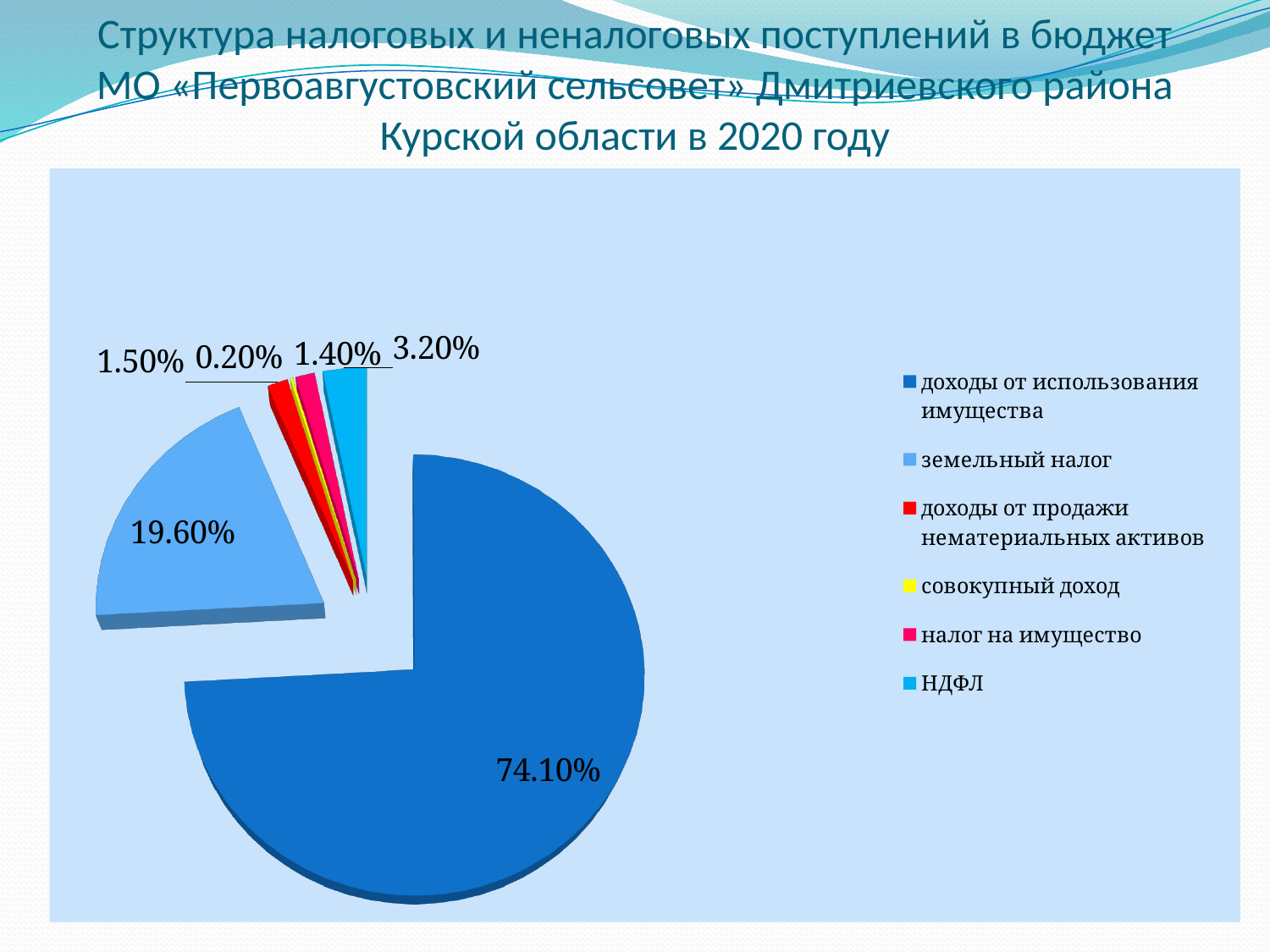
What share of the pie does "налог на имущество" have? 1.40% What share of the pie does "доходы от продажи нематериальных активов" have? 1.50% Which category has the largest share of the pie? доходы от использования имущества What share of the pie does "доходы от использования имущества" have? 74.10% What share of the pie does "НДФЛ" have? 3.20% Which category has the smallest share of the pie? совокупный доход What is the difference between the shares of "доходы от использования имущества" and "земельный налог"? 54.50% What share of the pie does "совокупный доход" have? 0.20% How many categories does the legend list? 6 What type of chart is shown on the slide? pie chart What share of the pie does "земельный налог" have? 19.60% Which is larger: the share of "НДФЛ" or the share of "налог на имущество"? НДФЛ